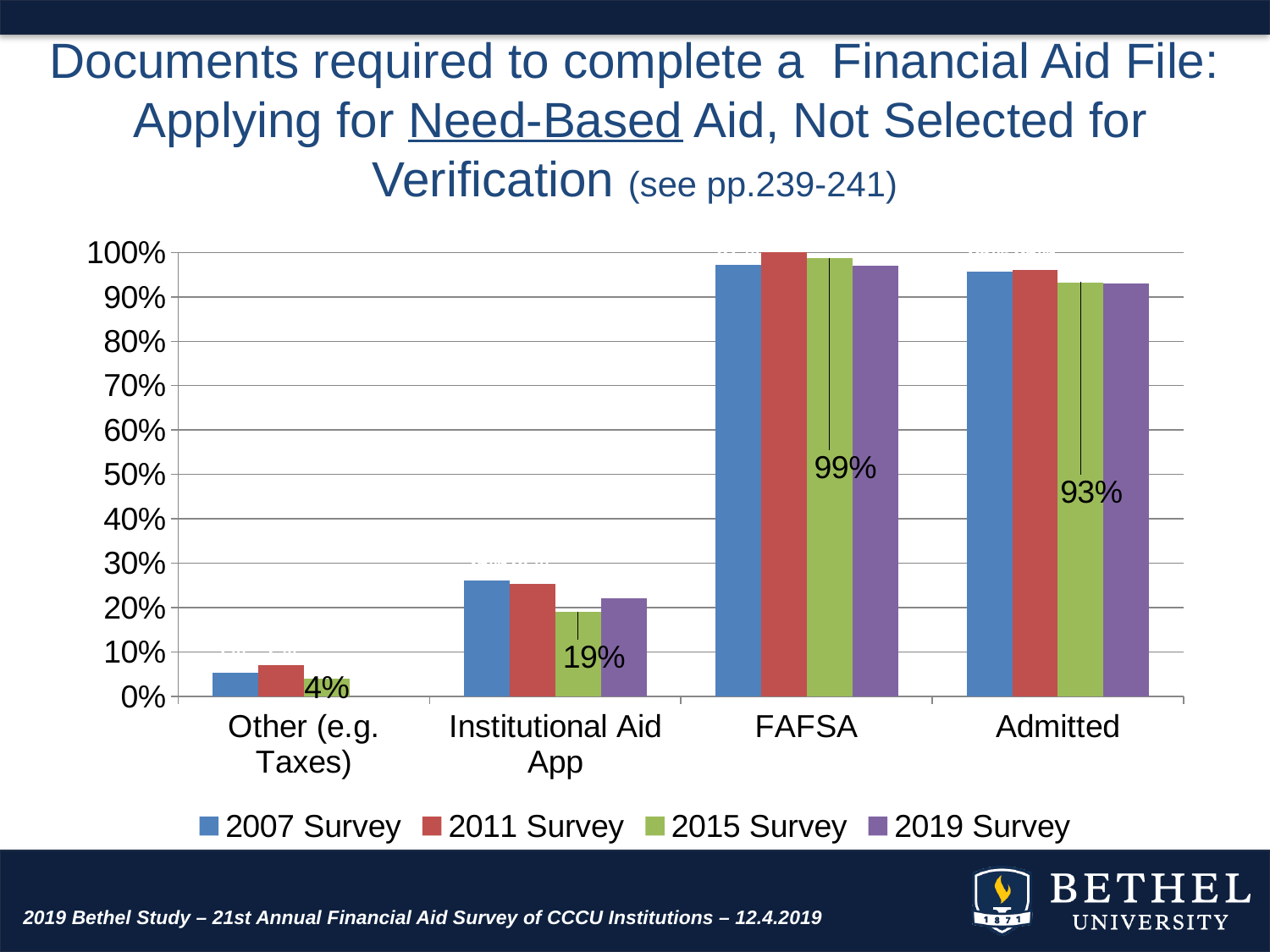
What is the 2015 Survey value for FAFSA? 99% Is the 2011 Survey value for Other (e.g. Taxes) greater or less than 10%? less What is the 2015 Survey value for Admitted? 93% What is the difference between the 2015 Survey values for FAFSA and Admitted? 6% Which category has the highest values across the surveys? FAFSA Which category has the lowest values across the surveys? Other (e.g. Taxes) How many series does the legend list? 4 For the 2015 Survey, which is larger: Institutional Aid App or Other (e.g. Taxes)? Institutional Aid App What is the 2015 Survey value for Institutional Aid App? 19% What is the 2015 Survey value for Other (e.g. Taxes)? 4% How many categories are shown on the x axis? 4 Is the 2007 Survey value for Institutional Aid App greater or less than 20%? greater